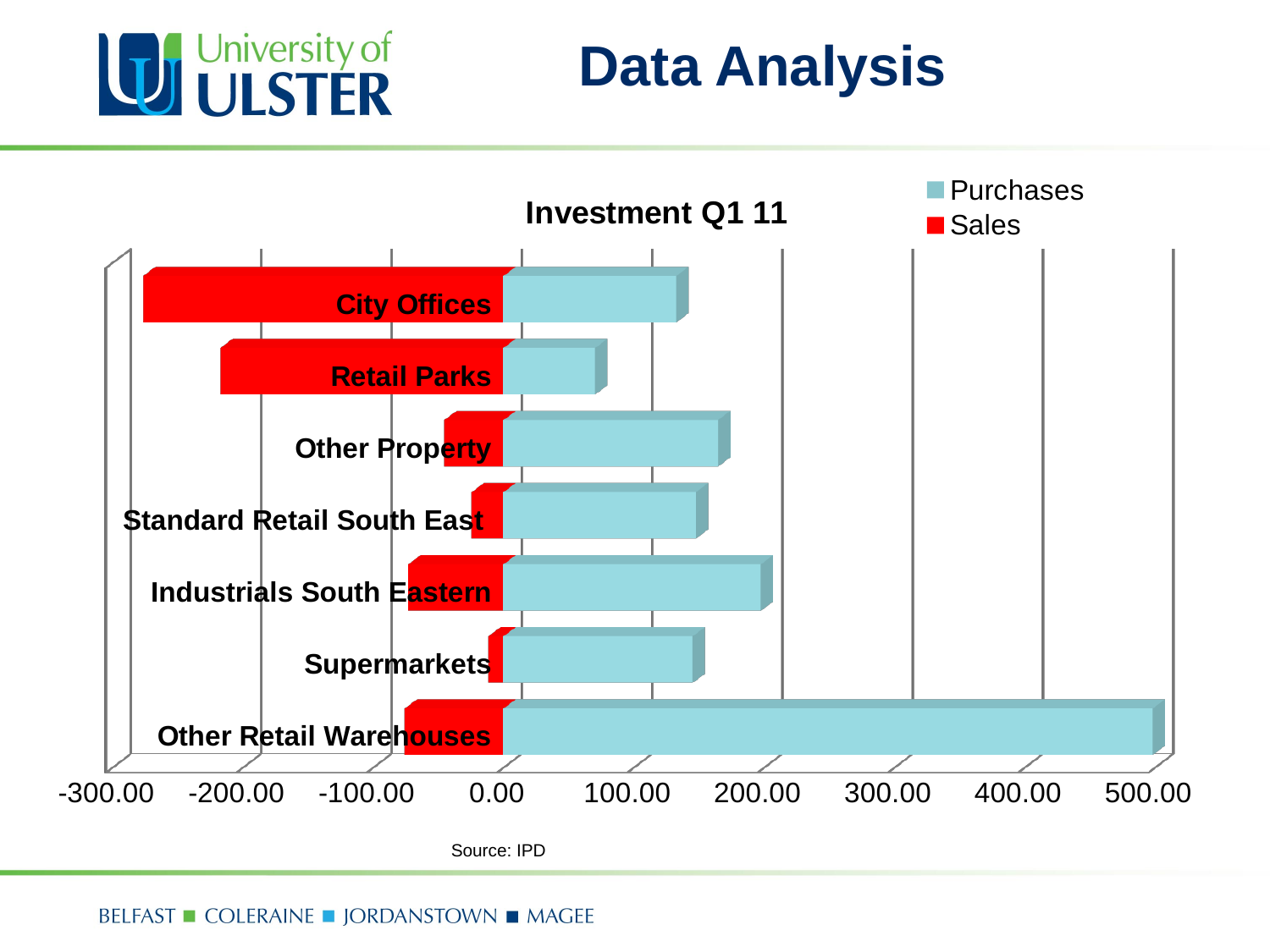
Which category has the largest Sales bar (most negative value)? City Offices Which category has the lowest Purchases value? Retail Parks What is the title of the chart? Investment Q1 11 How many categories are shown on the chart? 7 Which category has the highest Purchases value? Other Retail Warehouses Is the Purchases value for Retail Parks greater or less than 100.00? less Is the Purchases value for Other Retail Warehouses greater or less than 400.00? greater Which colour represents the Sales series in the legend? red How many series does the legend list? 2 What kind of chart is shown on the slide? bar chart Which has the larger Purchases value, Industrials South Eastern or Retail Parks? Industrials South Eastern Is the Sales value for City Offices greater or less than -200.00? less